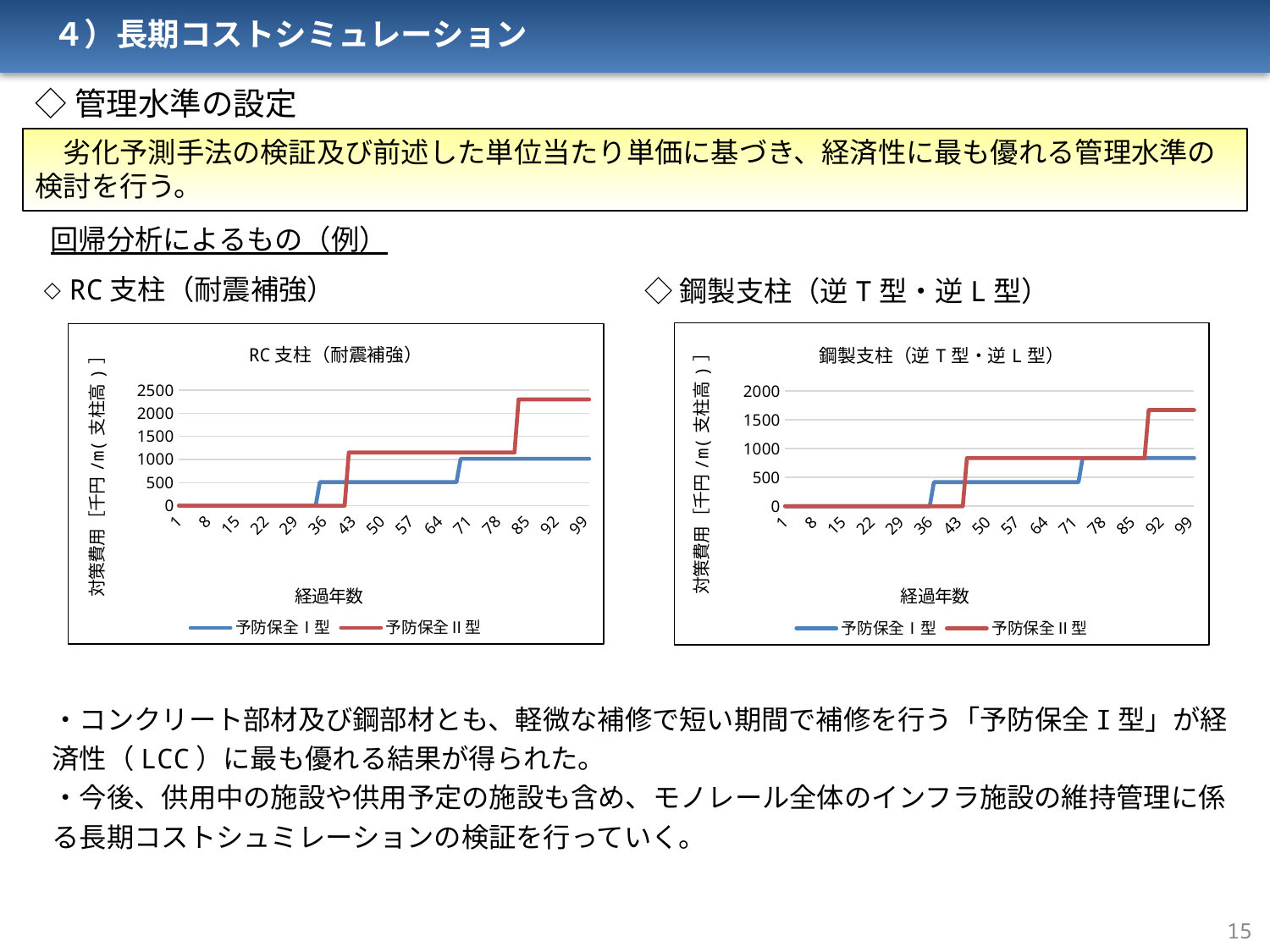
In the 鋼製支柱（逆Ｔ型・逆Ｌ型） chart, which series is drawn in red? 予防保全Ⅱ型 In the RC 支柱（耐震補強） chart, which series has the higher value at year 99, 予防保全Ⅰ型 or 予防保全Ⅱ型? 予防保全Ⅱ型 What kind of chart is the 鋼製支柱（逆Ｔ型・逆Ｌ型） chart? line chart What kind of chart is the RC 支柱（耐震補強） chart? line chart How many series does the legend of the RC 支柱（耐震補強） chart list? 2 In the 鋼製支柱（逆Ｔ型・逆Ｌ型） chart, which series has the higher value at year 99, 予防保全Ⅰ型 or 予防保全Ⅱ型? 予防保全Ⅱ型 In the RC 支柱（耐震補強） chart, is the value of 予防保全Ⅱ型 at year 99 greater or less than 2000? greater In the RC 支柱（耐震補強） chart, is the value of 予防保全Ⅰ型 at year 99 greater or less than 1500? less In the RC 支柱（耐震補強） chart, do the values of 予防保全Ⅱ型 rise or fall as 経過年数 increases? rise What is the x-axis title of the RC 支柱（耐震補強） chart? 経過年数 In the 鋼製支柱（逆Ｔ型・逆Ｌ型） chart, is the value of 予防保全Ⅱ型 at year 99 greater or less than 1500? greater